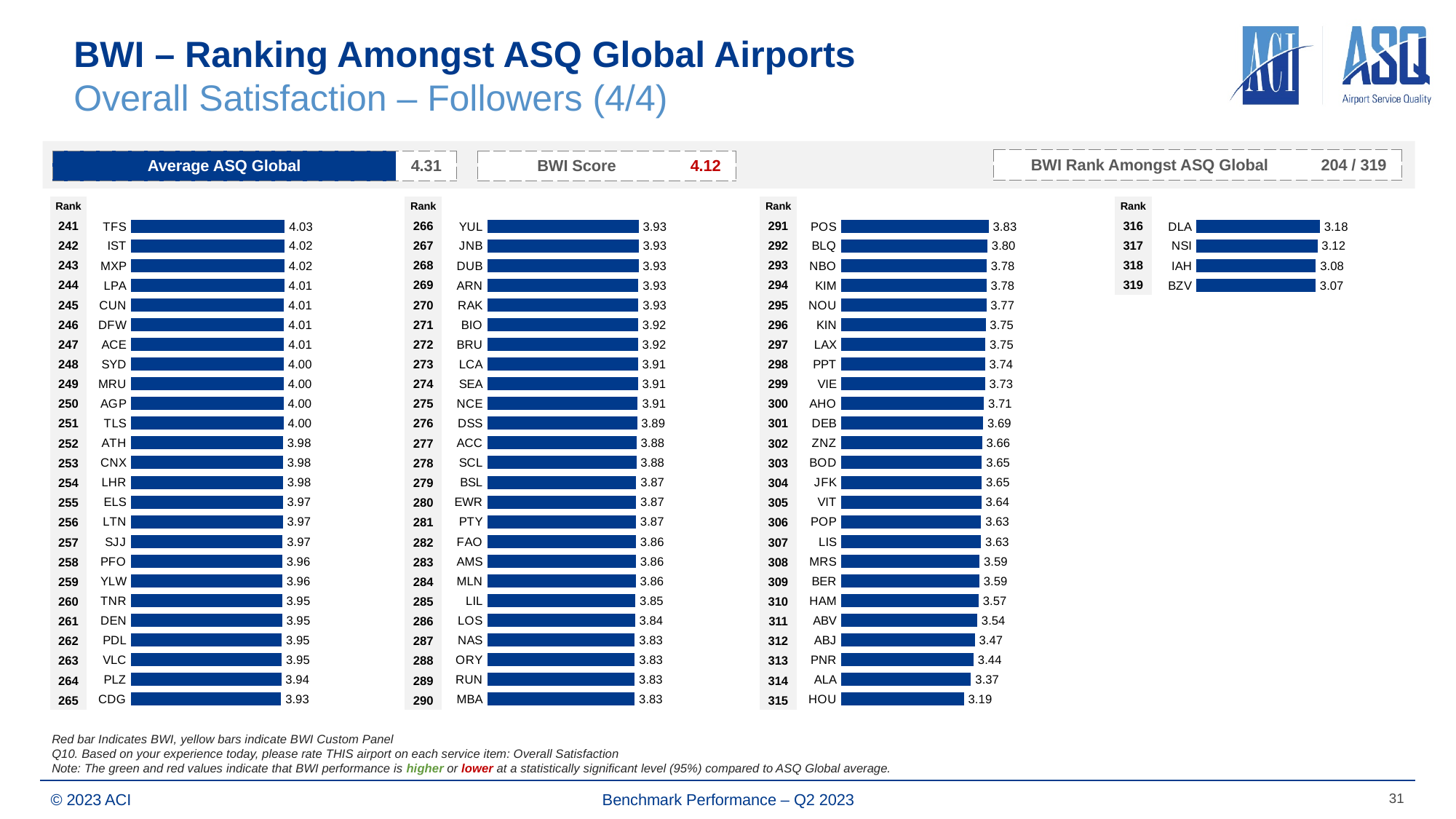
What kind of chart is used to show the airport scores on this slide? Bar chart In the third chart from the left (ranks 291–315), what is the value for LAX? 3.75 In the third chart from the left (ranks 291–315), which airport has the lowest value? HOU In the rightmost chart (ranks 316–319), which airport has the highest value? DLA How many airports are plotted in the leftmost chart (ranks 241–265)? 25 What is the BWI Score shown at the top of the slide? 4.12 In the leftmost chart (ranks 241–265), what is the value for TFS? 4.03 How many airports are plotted in the rightmost chart (ranks 316–319)? 4 In the second chart from the left (ranks 266–290), what is the value for SEA? 3.91 In the third chart from the left (ranks 291–315), which is larger, the value for POS or the value for HOU? POS In the rightmost chart (ranks 316–319), what is the value for BZV? 3.07 In the leftmost chart (ranks 241–265), what is the difference between the values for TFS and CDG? 0.10